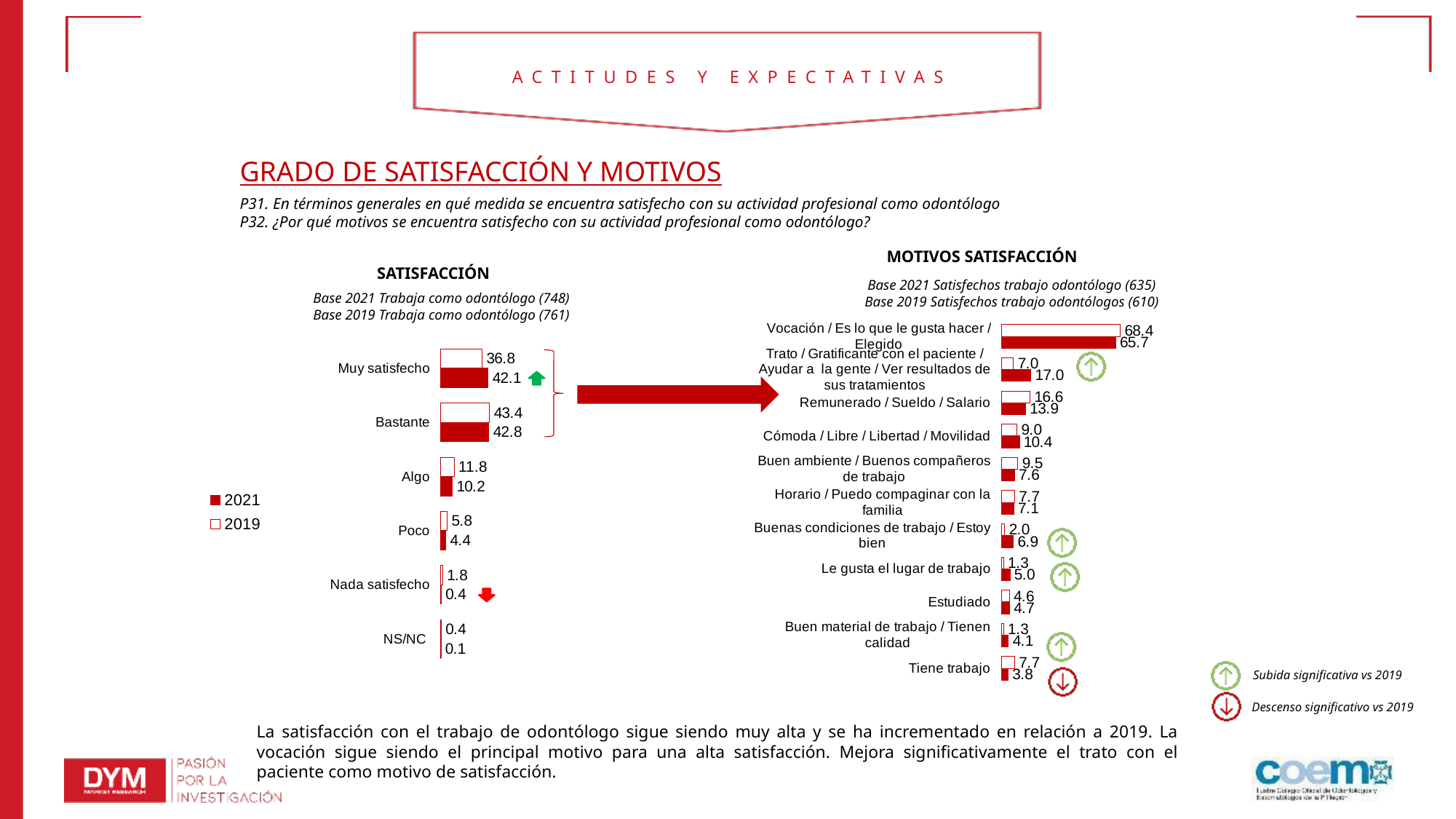
In the SATISFACCIÓN chart, which category has the lowest 2021 value? NS/NC In the MOTIVOS SATISFACCIÓN chart, what is the 2021 value for Trato / Gratificante con el paciente / Ayudar a la gente / Ver resultados de sus tratamientos? 17.0 In the MOTIVOS SATISFACCIÓN chart, is the 2021 value for Remunerado / Sueldo / Salario larger or smaller than its 2019 value? smaller In the MOTIVOS SATISFACCIÓN chart, how many motives are listed? 11 In the SATISFACCIÓN chart, how many categories are shown? 6 In the SATISFACCIÓN chart, how many series does the legend list? 2 In the SATISFACCIÓN chart, what is the 2021 value for Muy satisfecho? 42.1 In the SATISFACCIÓN chart, what is the difference between the 2021 and 2019 values for Muy satisfecho? 5.3 In the MOTIVOS SATISFACCIÓN chart, which motive has the highest 2021 value? Vocación / Es lo que le gusta hacer / Elegido In the SATISFACCIÓN chart, what is the 2019 value for Bastante? 43.4 What type of chart is the SATISFACCIÓN chart? Bar chart In the MOTIVOS SATISFACCIÓN chart, what is the difference between the 2019 and 2021 values for Tiene trabajo? 3.9